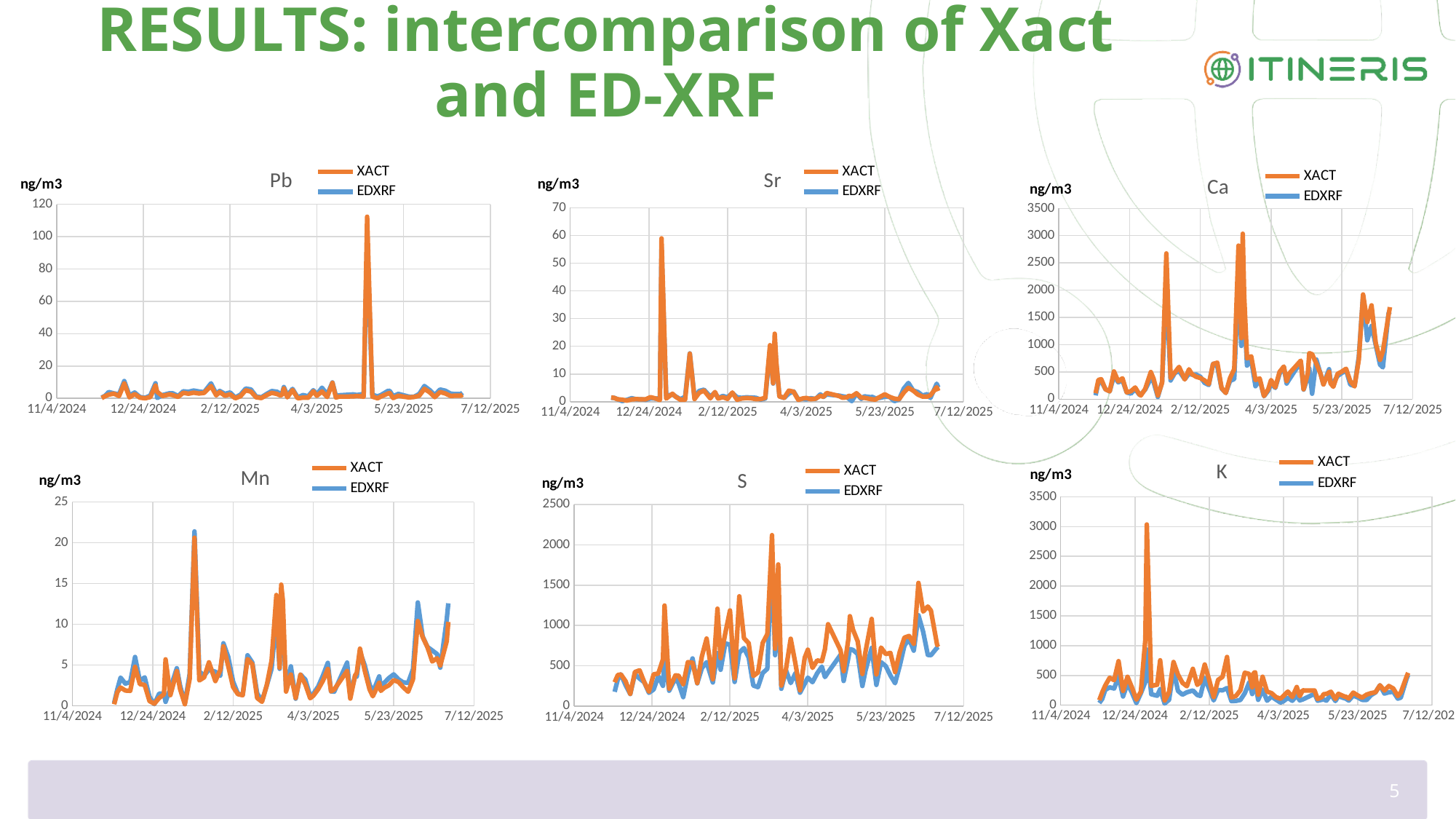
How many charts are shown on the slide? 6 In the K chart, is the highest XACT value greater or less than 2500? greater In the Pb chart, is the XACT value at 2/12/2025 greater or less than 20? less What are the two series named in the legend of the Ca chart? XACT and EDXRF What unit is shown on the y axis of the Mn chart? ng/m3 In the Ca chart, is the highest XACT value greater or less than 2500? greater How many series does the legend of the Sr chart list? 2 What kind of chart is the Pb chart? line chart